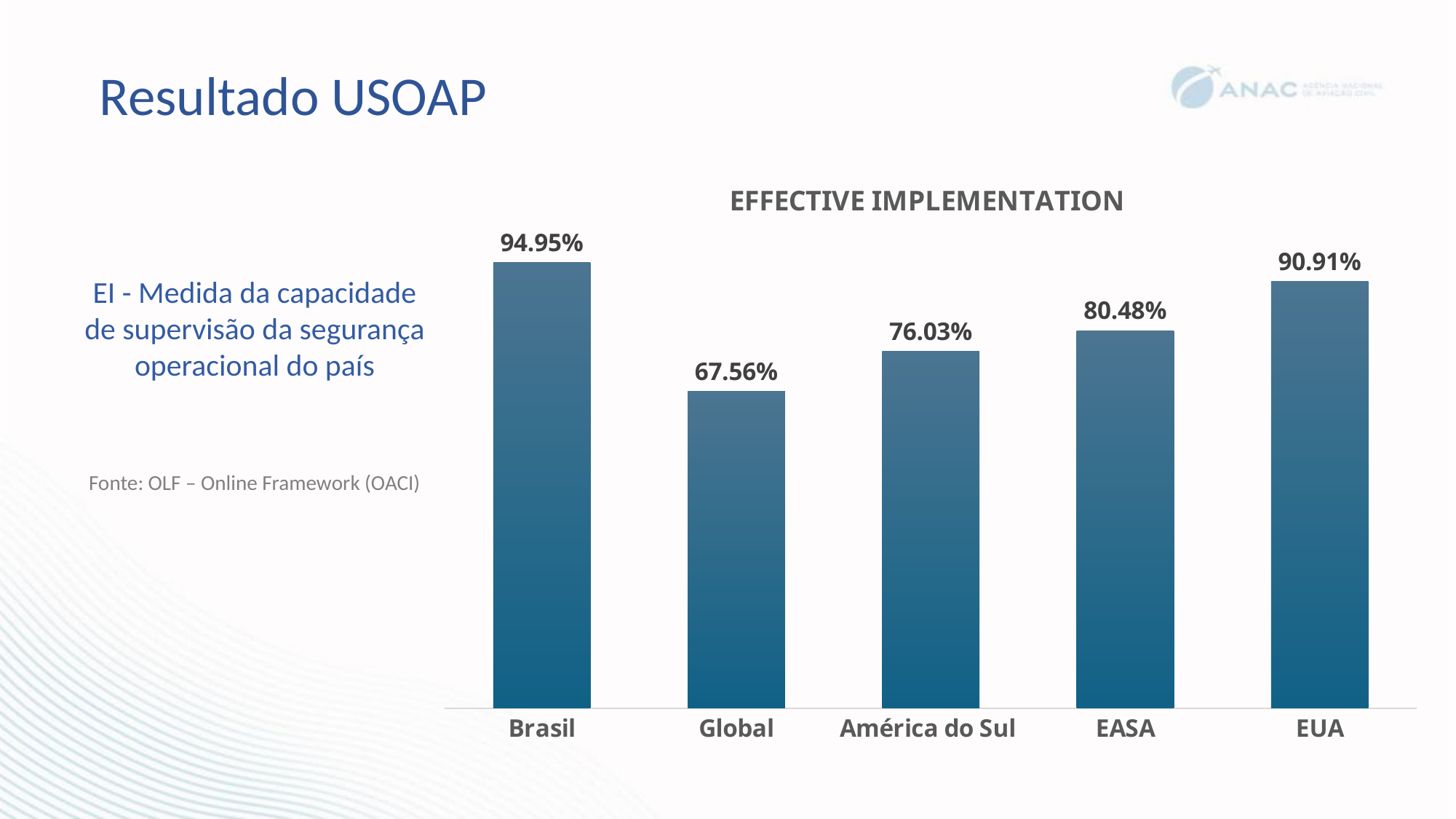
What is the Effective Implementation value for EASA? 80.48% What type of chart is shown on the slide? Bar chart Which category has the lowest Effective Implementation value? Global What is the difference between the Effective Implementation values for EUA and EASA? 10.43% How many categories are shown in the chart? 5 What is the Effective Implementation value for EUA? 90.91% What is the Effective Implementation value for Brasil? 94.95% What is the Effective Implementation value for América do Sul? 76.03% Which has a higher Effective Implementation value, EASA or América do Sul? EASA Which category has the highest Effective Implementation value? Brasil What is the Effective Implementation value for Global? 67.56% What is the difference between the Effective Implementation values for Brasil and Global? 27.39%